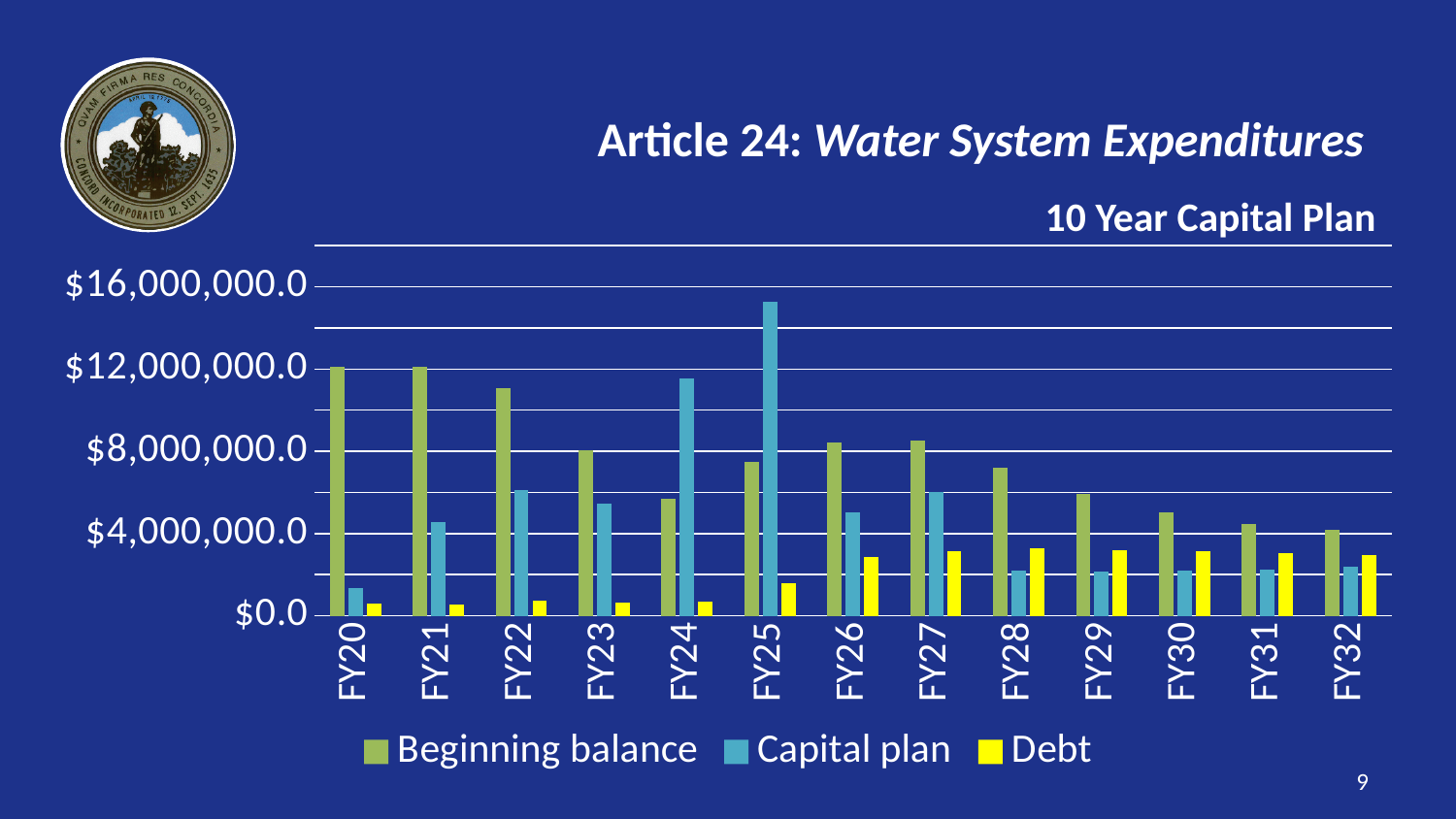
Which series is shown in yellow in the chart's legend? Debt In which fiscal year is the Capital plan value highest? FY25 How many series does the chart's legend list? 3 Is the Debt value for FY20 greater or less than $4,000,000.0? less How many fiscal years are shown on the x axis of the chart? 13 Is the Capital plan value for FY25 greater or less than $12,000,000.0? greater Which is larger in FY24, the Beginning balance or the Capital plan? Capital plan Is the Capital plan value for FY24 greater or less than $8,000,000.0? greater What kind of chart is shown on the slide? bar chart Which is larger in FY22, the Beginning balance or the Capital plan? Beginning balance Does the Beginning balance rise or fall from FY27 to FY32? fall